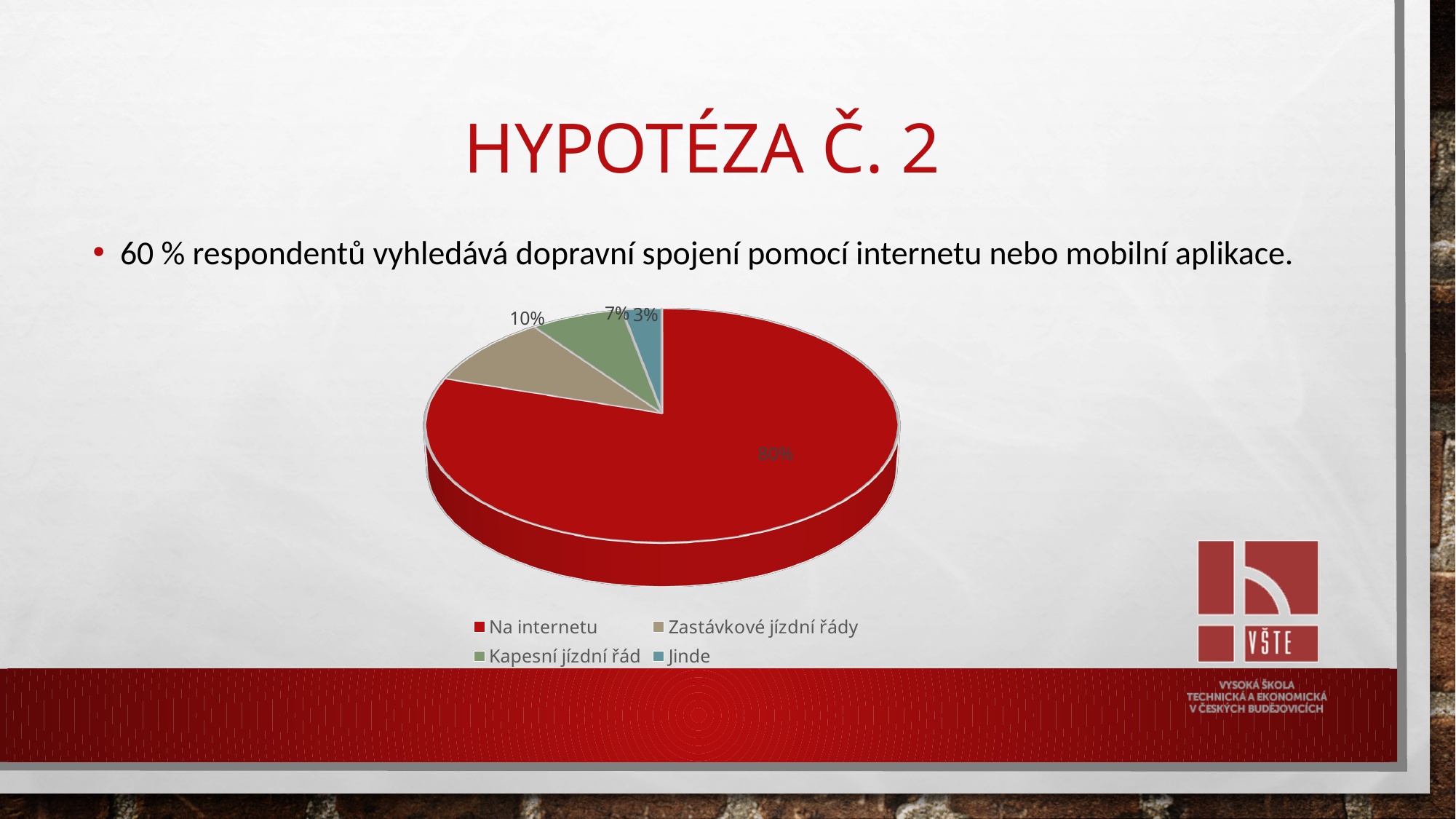
What share of the pie does "Na internetu" have? 80% How many categories does the pie chart show? 4 What is the difference in percentage points between "Na internetu" and "Zastávkové jízdní řády"? 70 Which is larger, the slice for "Kapesní jízdní řád" or the slice for "Jinde"? Kapesní jízdní řád What share of the pie does "Jinde" have? 3% What kind of chart is shown on the slide? pie chart Which category has the largest slice of the pie? Na internetu Which category has the smallest slice of the pie? Jinde What colour is the slice for "Na internetu"? red What is the difference in percentage points between "Kapesní jízdní řád" and "Jinde"? 4 What share of the pie does "Kapesní jízdní řád" have? 7%